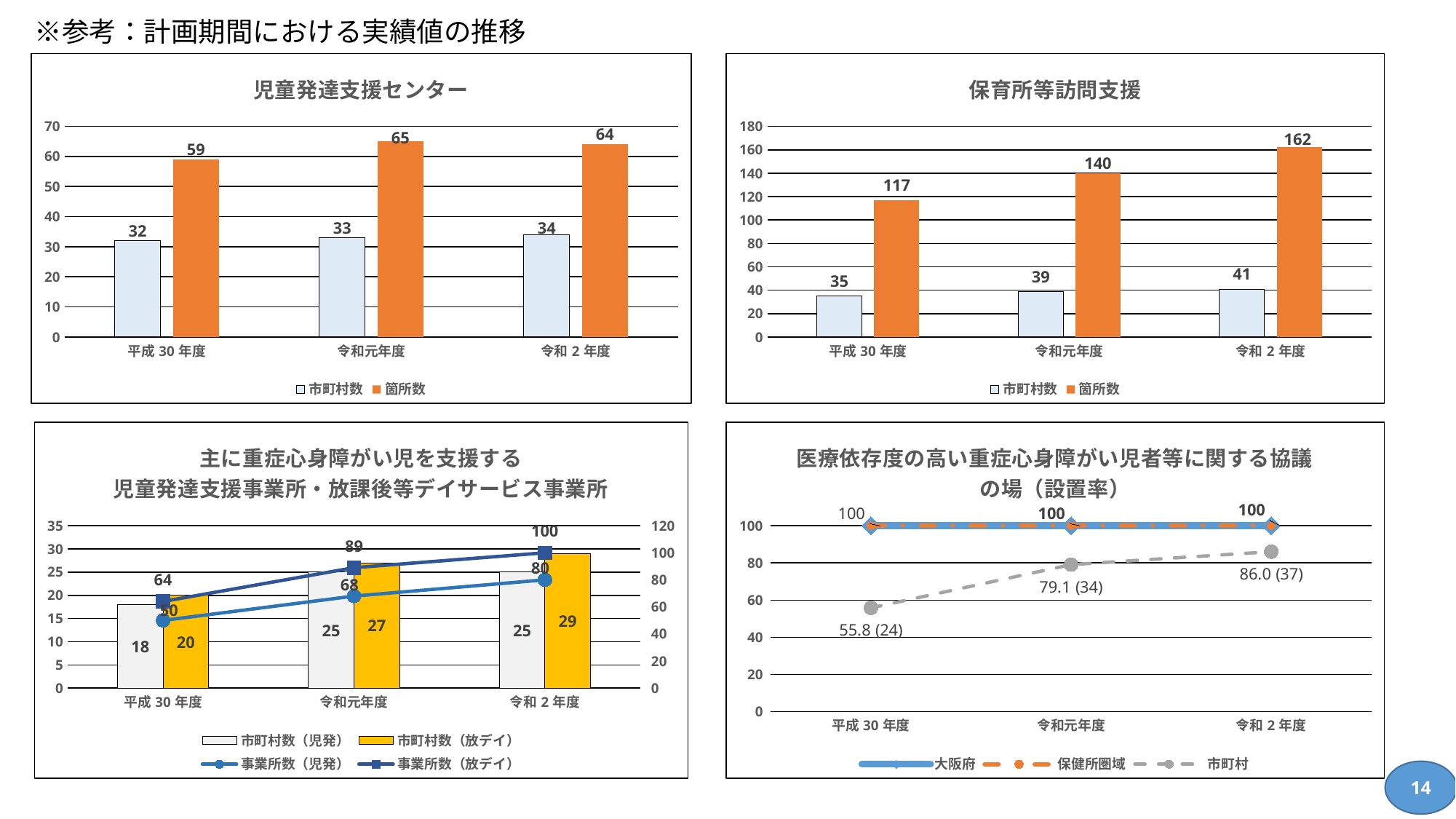
In the 児童発達支援センター chart, which year has the highest 箇所数? 令和元年度 What kind of chart is the bottom-right chart (医療依存度の高い重症心身障がい児者等に関する協議の場（設置率）)? line chart In the 保育所等訪問支援 chart, what is the difference in 箇所数 between 令和2年度 and 令和元年度? 22 In the 保育所等訪問支援 chart, how many series does the legend list? 2 In the bottom-left chart (主に重症心身障がい児を支援する児童発達支援事業所・放課後等デイサービス事業所), what is the 事業所数（放デイ） value for 令和元年度? 89 In the bottom-left chart, how many series does the legend list? 4 In the 児童発達支援センター chart, what is the difference between 箇所数 and 市町村数 in 平成30年度? 27 In the bottom-left chart, what is the 市町村数（放デイ） value for 令和2年度? 29 In the 保育所等訪問支援 chart, does the 箇所数 rise or fall from 平成30年度 to 令和2年度? rise In the bottom-right chart (医療依存度の高い重症心身障がい児者等に関する協議の場（設置率）), what is the 市町村 value for 平成30年度? 55.8 (24) In the 保育所等訪問支援 chart, what is the 箇所数 value for 令和2年度? 162 In the 児童発達支援センター chart, what is the 箇所数 value for 令和元年度? 65